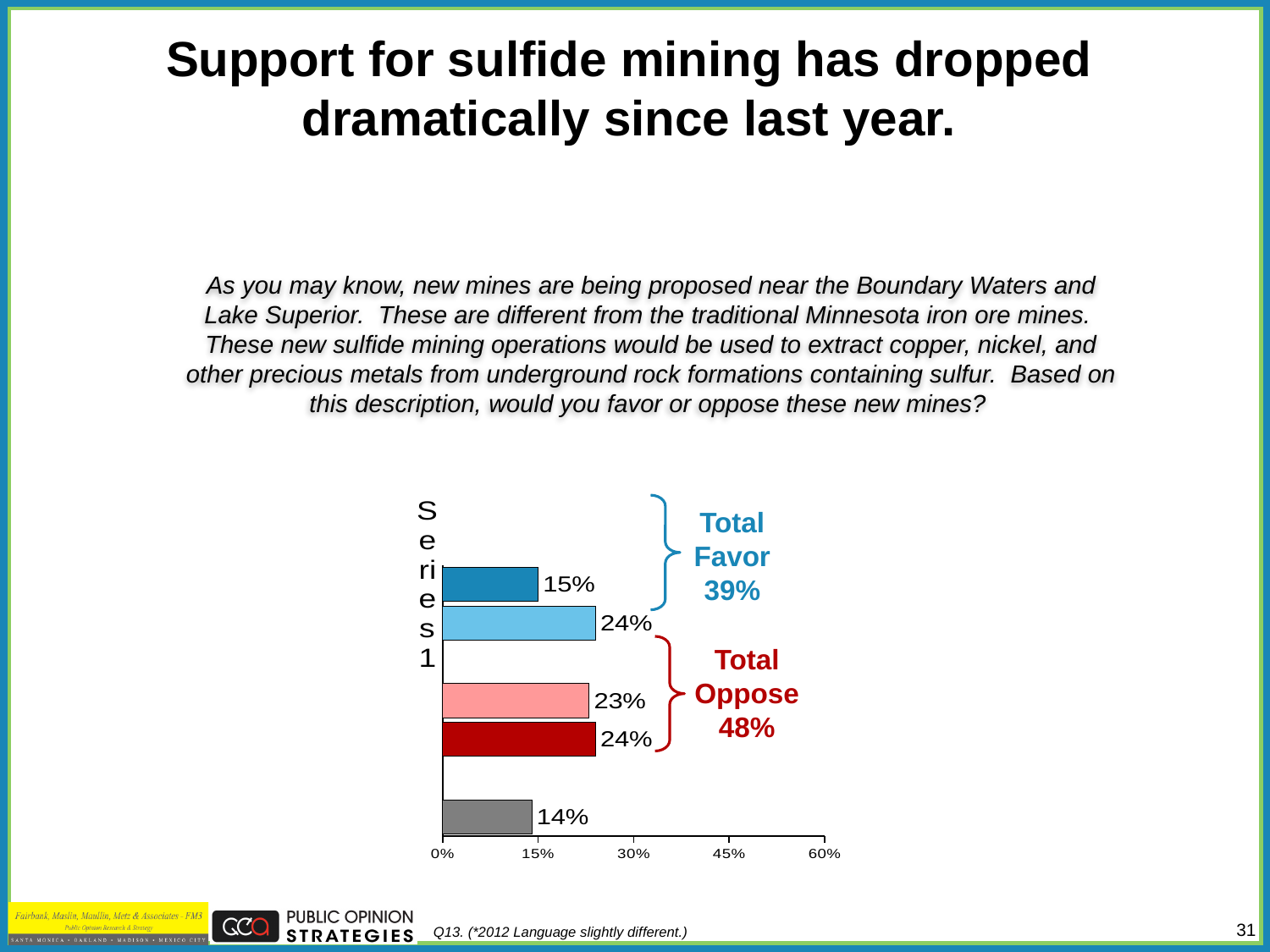
How many bars are plotted in the chart? 5 What type of chart is shown on the slide? bar chart What is the largest value labeled on any bar in the chart? 24% Is the value of the dark red bar greater or less than 30%? less What is the value shown on the bottom (gray) bar of the chart? 14% What is the difference between the light blue bar (24%) and the dark blue bar (15%)? 9 percentage points What is the Total Oppose percentage shown next to the chart? 48% What is the highest value shown on the chart's horizontal axis? 60% What is the Total Favor percentage shown next to the chart? 39% What is the smallest value labeled on any bar in the chart? 14% What is the value shown on the top (dark blue) bar of the chart? 15% By how many percentage points does Total Oppose exceed Total Favor? 9